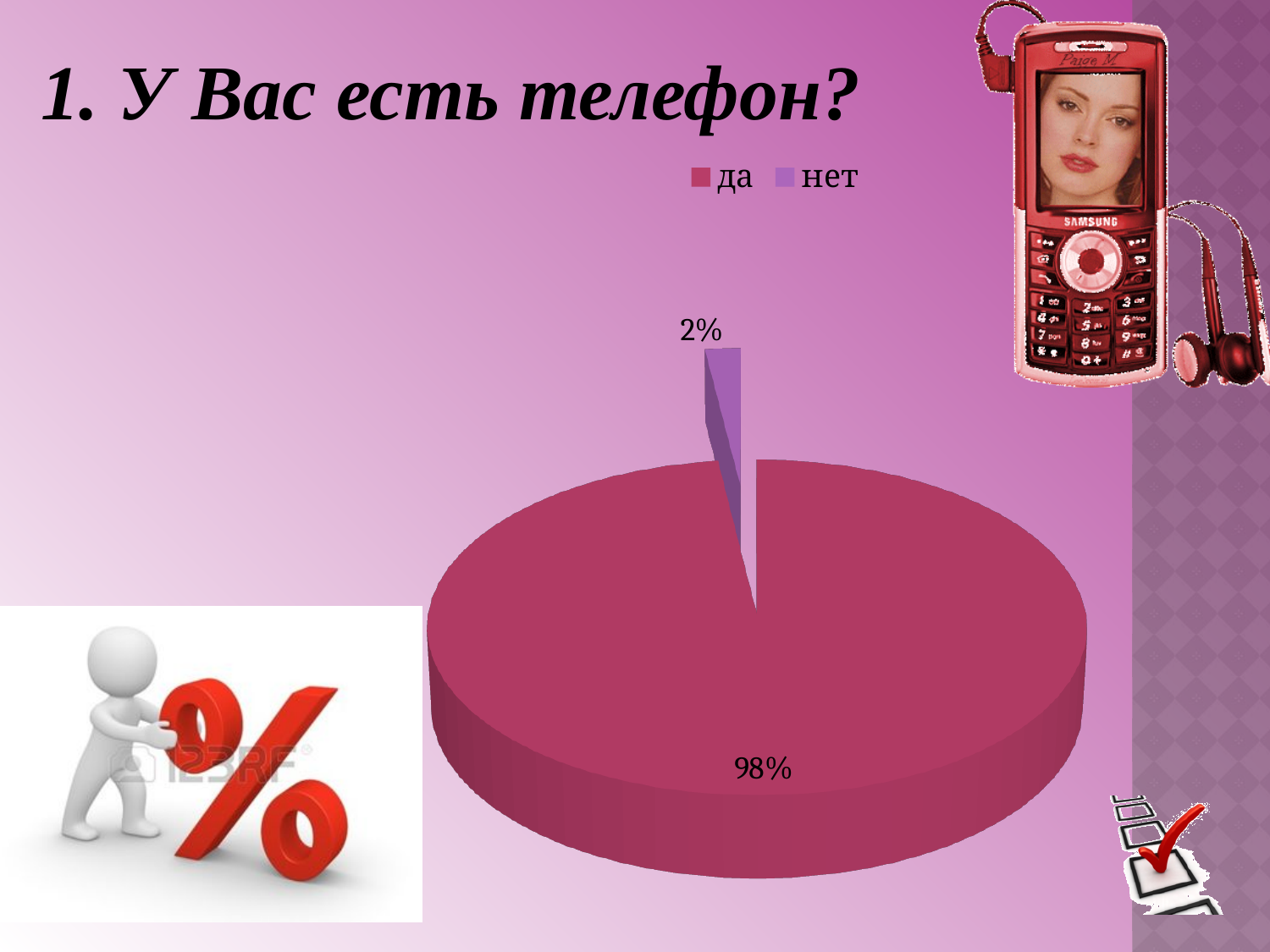
Which slice is the smallest? нет How many entries does the legend list? 2 How many slices does the pie chart have? 2 Which is larger, the "да" slice or the "нет" slice? да What kind of chart is shown on the slide? pie chart What is the title of the slide above the chart? 1. У Вас есть телефон? Which legend entry is shown in purple? нет What share of the pie does "да" take? 98% Which slice is the largest? да What share of the pie does "нет" take? 2% What is the difference between the "да" and "нет" shares? 96%